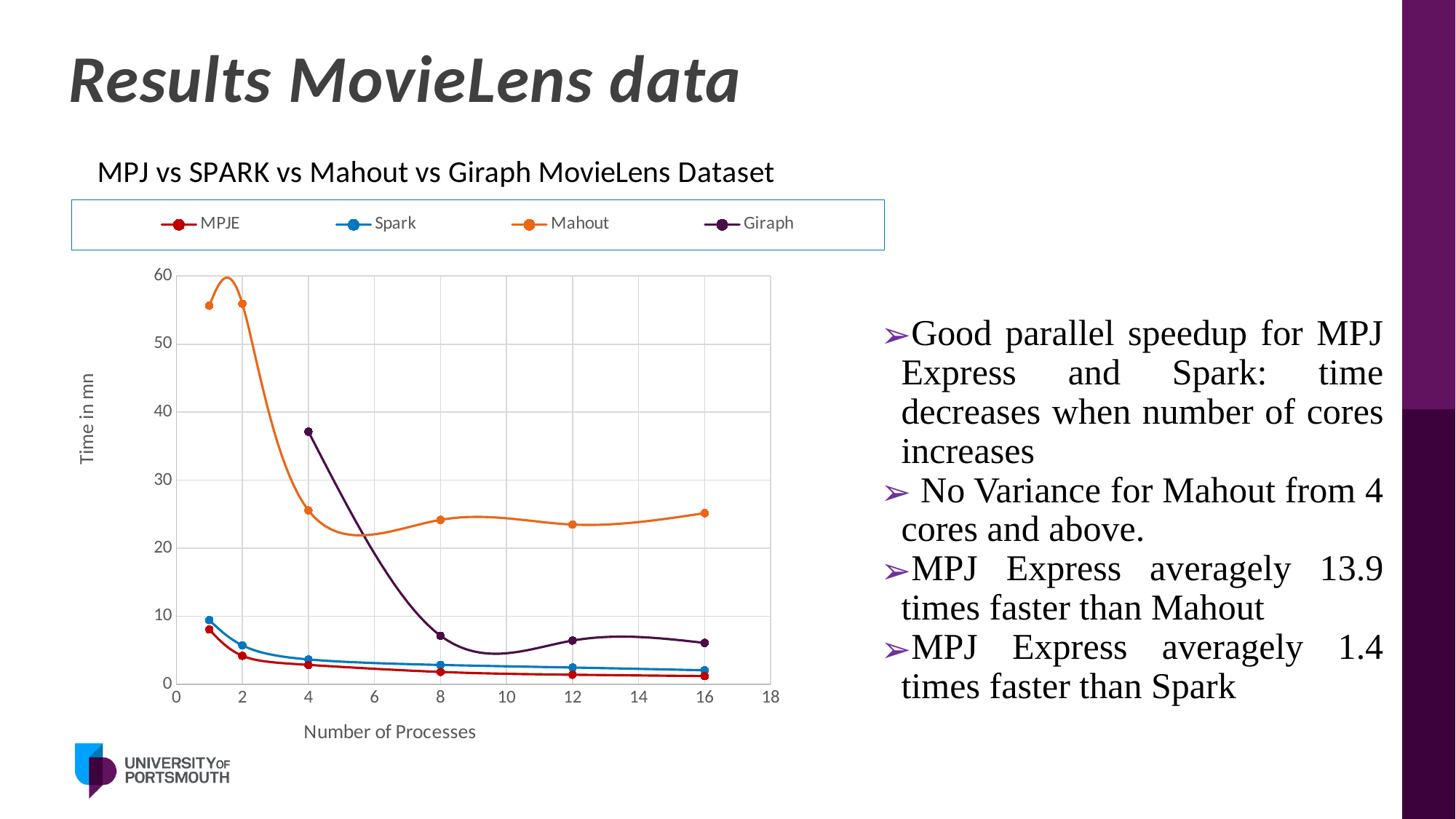
What is the title of the x axis? Number of Processes Is the value for Mahout at 2 processes greater or less than 50? greater Is the value for Giraph at 8 processes greater or less than 10? less What is the title of the chart? MPJ vs SPARK vs Mahout vs Giraph MovieLens Dataset What kind of chart is shown on the slide? line chart At 8 processes, which is larger: the value for Mahout or the value for Giraph? Mahout Do the values for Spark rise or fall as the number of processes increases? fall Which series has the highest time at 16 processes? Mahout Is the value for Giraph at 4 processes greater or less than 30? greater How many data points are plotted for the Giraph series? 4 How many series does the legend list? 4 Which series has the highest time at 4 processes? Giraph